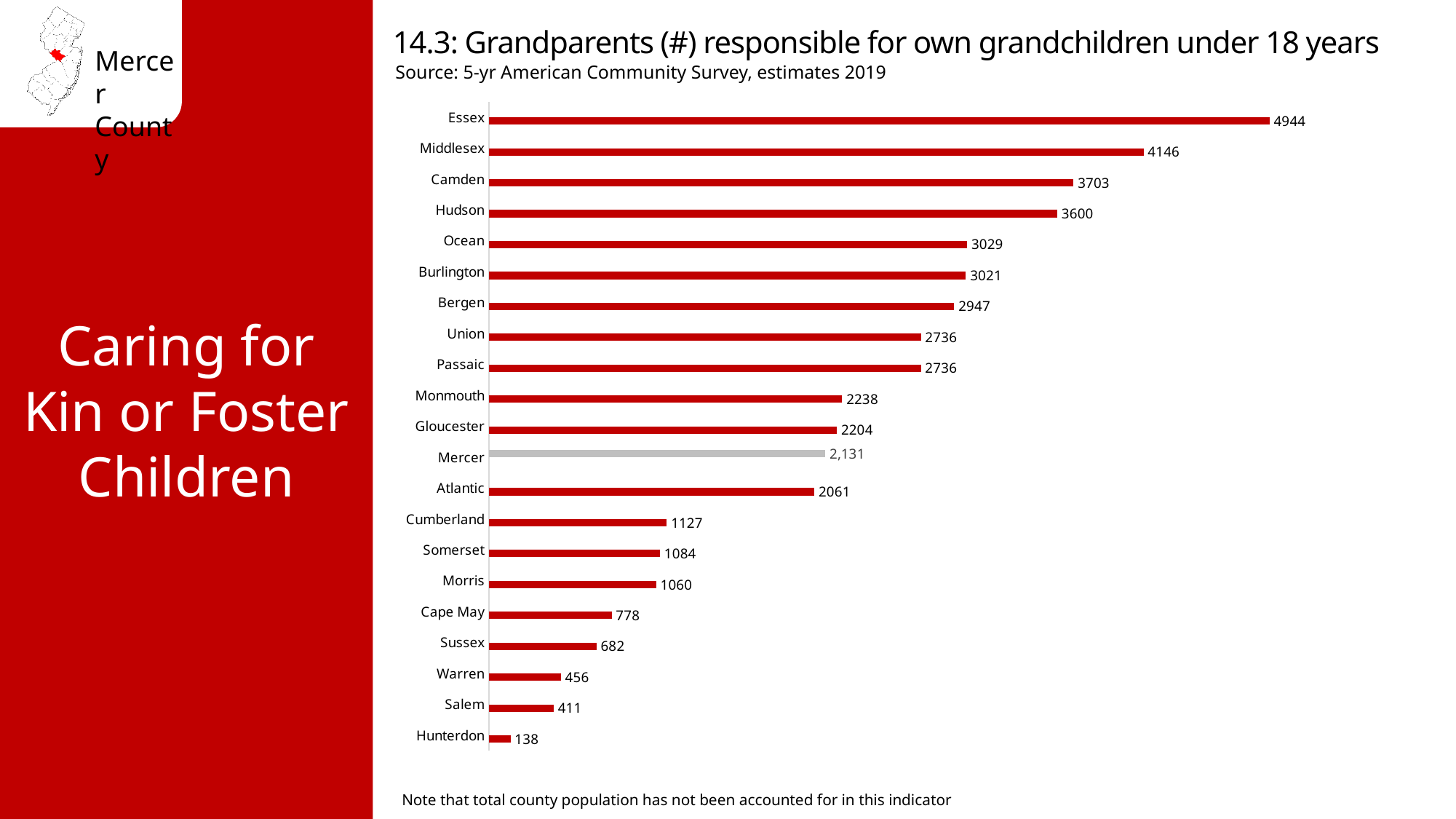
What is the difference between the values for Essex and Middlesex? 798 What kind of chart is shown on the slide? Bar chart What is the source cited for the chart? 5-yr American Community Survey, estimates 2019 Which county has the highest value in the chart? Essex What is the value for Hunterdon in the chart? 138 How many counties are shown in the chart? 21 What is the value for Essex in the chart? 4944 Which is larger, the value for Monmouth or the value for Atlantic? Monmouth Which county's bar is shown in grey rather than red? Mercer What is the value for Mercer in the chart? 2,131 What is the difference between the values for Camden and Hudson? 103 Which county has the lowest value in the chart? Hunterdon